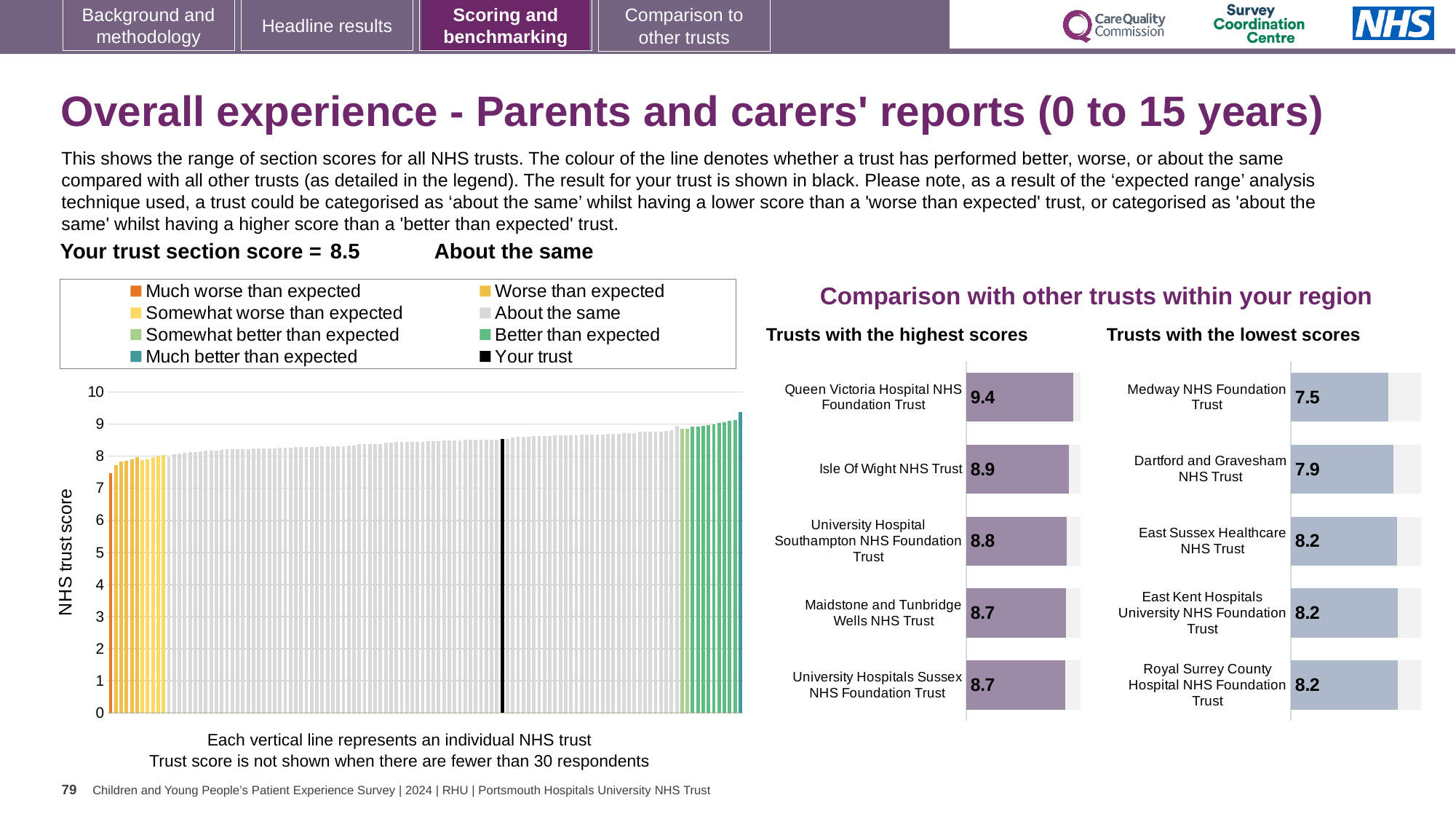
In the 'Trusts with the lowest scores' chart, which trust has the lowest score? Medway NHS Foundation Trust In the 'Trusts with the highest scores' chart, what is the difference between the scores of Queen Victoria Hospital NHS Foundation Trust and Isle Of Wight NHS Trust? 0.5 What kind of chart is the large 'NHS trust score' chart on the left of the slide? Bar chart In the 'Trusts with the lowest scores' chart, what is the score for Medway NHS Foundation Trust? 7.5 How many entries does the legend of the 'NHS trust score' chart list? 8 In the 'NHS trust score' chart, is the value for 'Your trust' (the black bar) greater or less than 8? greater In the 'Trusts with the highest scores' chart, what is the score for Queen Victoria Hospital NHS Foundation Trust? 9.4 In the 'Trusts with the highest scores' chart, which trust has the highest score? Queen Victoria Hospital NHS Foundation Trust How many trusts are shown in the 'Trusts with the highest scores' chart? 5 In the 'Trusts with the lowest scores' chart, what is the score for Royal Surrey County Hospital NHS Foundation Trust? 8.2 In the 'Trusts with the lowest scores' chart, what is the difference between the scores of Dartford and Gravesham NHS Trust and Medway NHS Foundation Trust? 0.4 In the 'Trusts with the highest scores' chart, which has the higher score: University Hospital Southampton NHS Foundation Trust or Maidstone and Tunbridge Wells NHS Trust? University Hospital Southampton NHS Foundation Trust